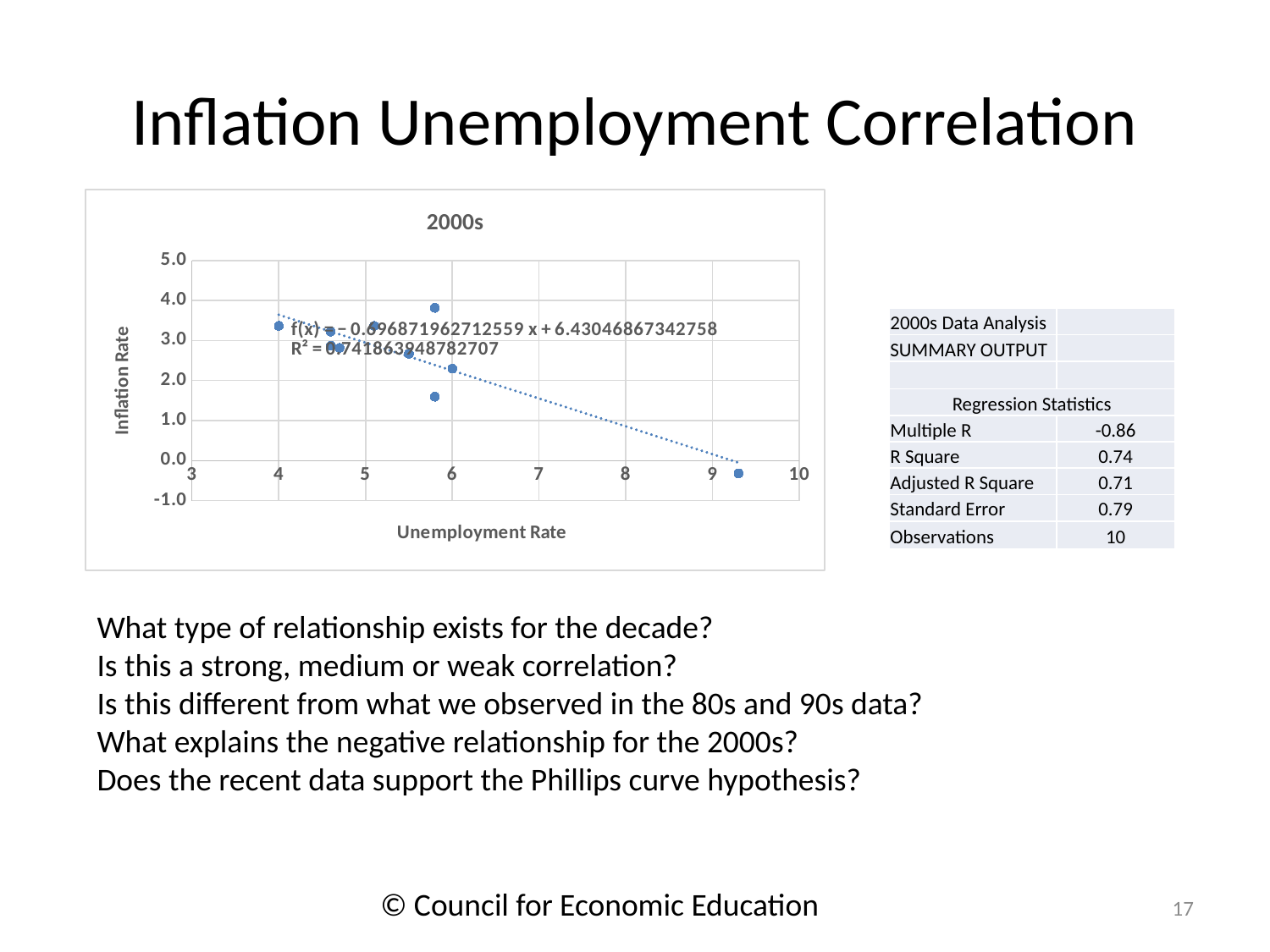
What kind of chart is shown on the slide? Scatter chart Is the inflation rate of the point with the highest unemployment rate (near 9) greater or less than 0.0? less Is the inflation rate of the point at an unemployment rate of about 4 greater or less than 3.0? greater What is the title of the chart? 2000s What is the highest value shown on the y axis of the chart? 5.0 Is the inflation rate of the highest point on the chart greater or less than 3.0? greater Which has the higher inflation rate: the point at an unemployment rate of about 4 or the point at an unemployment rate of about 9? The point at about 4 As the unemployment rate increases along the x axis, do the inflation rate values generally rise or fall? Fall What is the label of the x axis of the chart? Unemployment Rate